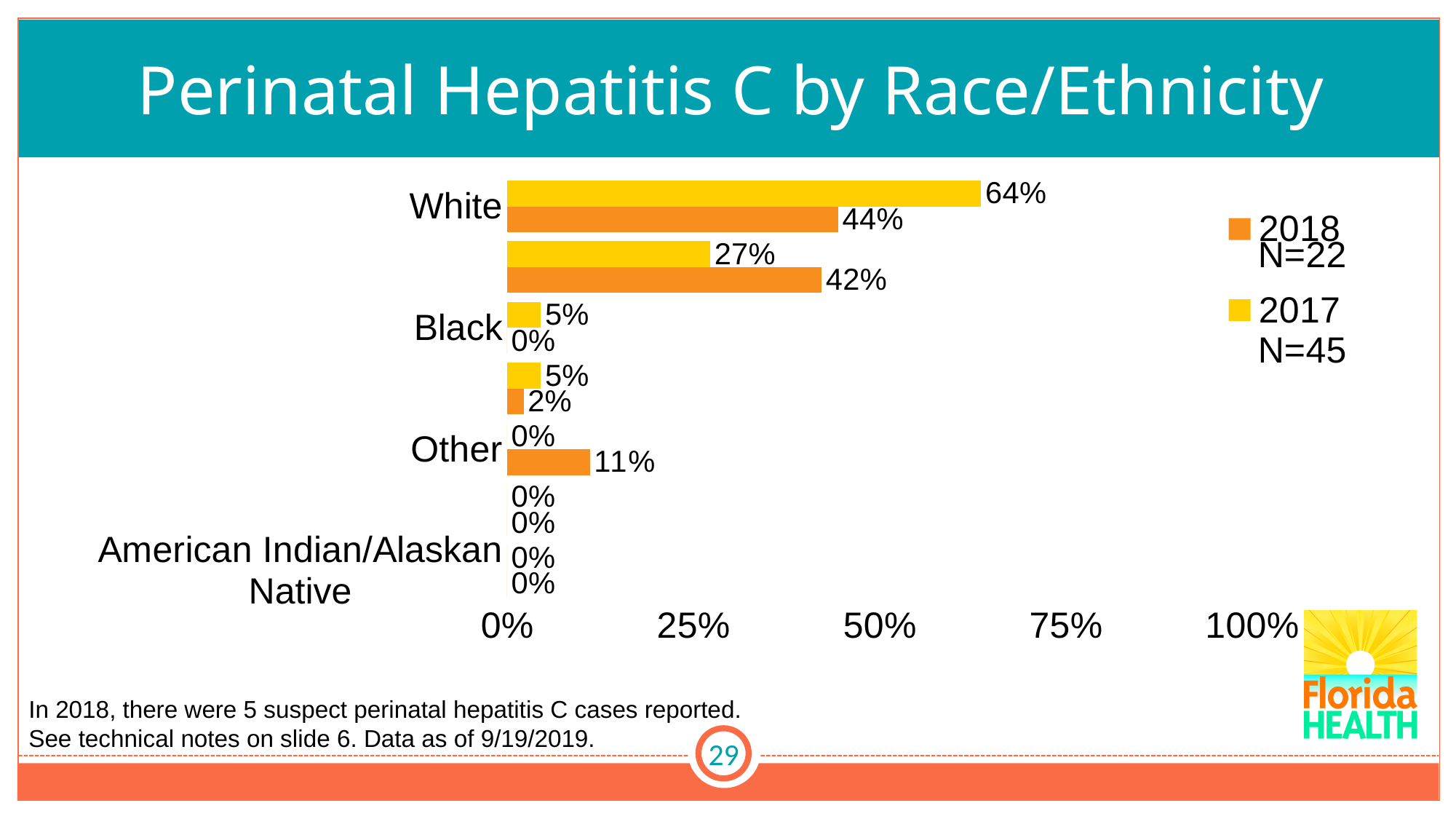
Which race/ethnicity category has the highest 2017 value? White What is the difference between the 2017 and 2018 values for White? 20 percentage points What is the 2018 value for American Indian/Alaskan Native? 0% What N value does the legend give for 2018? N=22 What is the 2018 value for White? 44% What is the 2018 value for Other? 11% Is the 2017 value for White greater or less than 50%? greater What is the 2017 value for White? 64% What kind of chart is shown on the slide? Bar chart How many series does the legend list? 2 What is the 2017 value for Black? 5% For White, which year has the larger value, 2017 or 2018? 2017